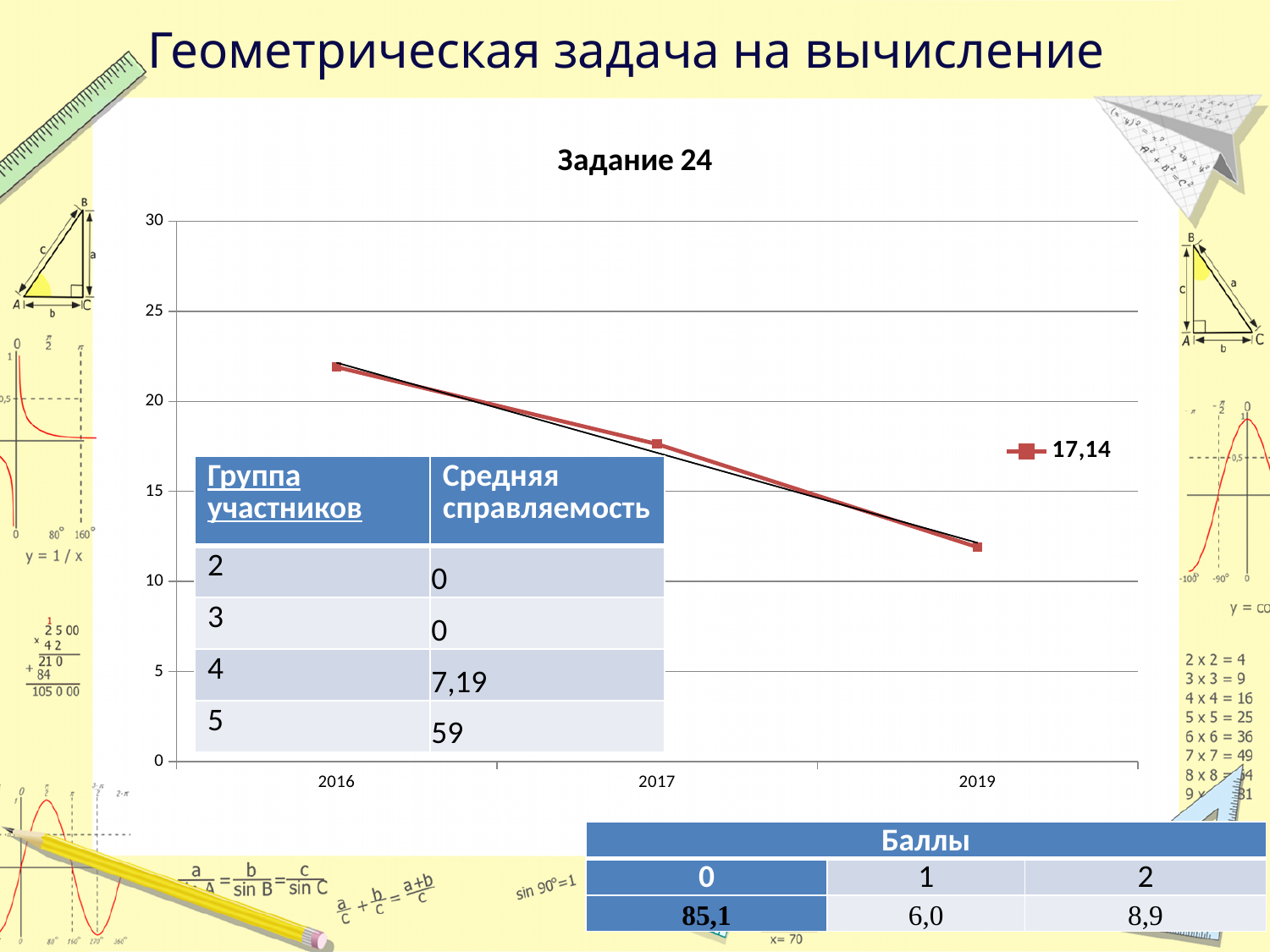
Is the value for 2017 greater or less than 20? less Is the value for 2016 greater or less than 20? greater Which is larger, the value for 2017 or the value for 2019? 2017 Which year has the highest value on the chart? 2016 What is the legend entry shown for the plotted series? 17,14 Is the value for 2019 greater or less than 15? less How many series does the chart legend list? 1 What is the title of the chart? Задание 24 Which year has the lowest value on the chart? 2019 How many data points are plotted on the line in the chart? 3 Do the values rise or fall from 2016 to 2019 along the x axis? fall What type of chart is shown under the title "Задание 24"? line chart